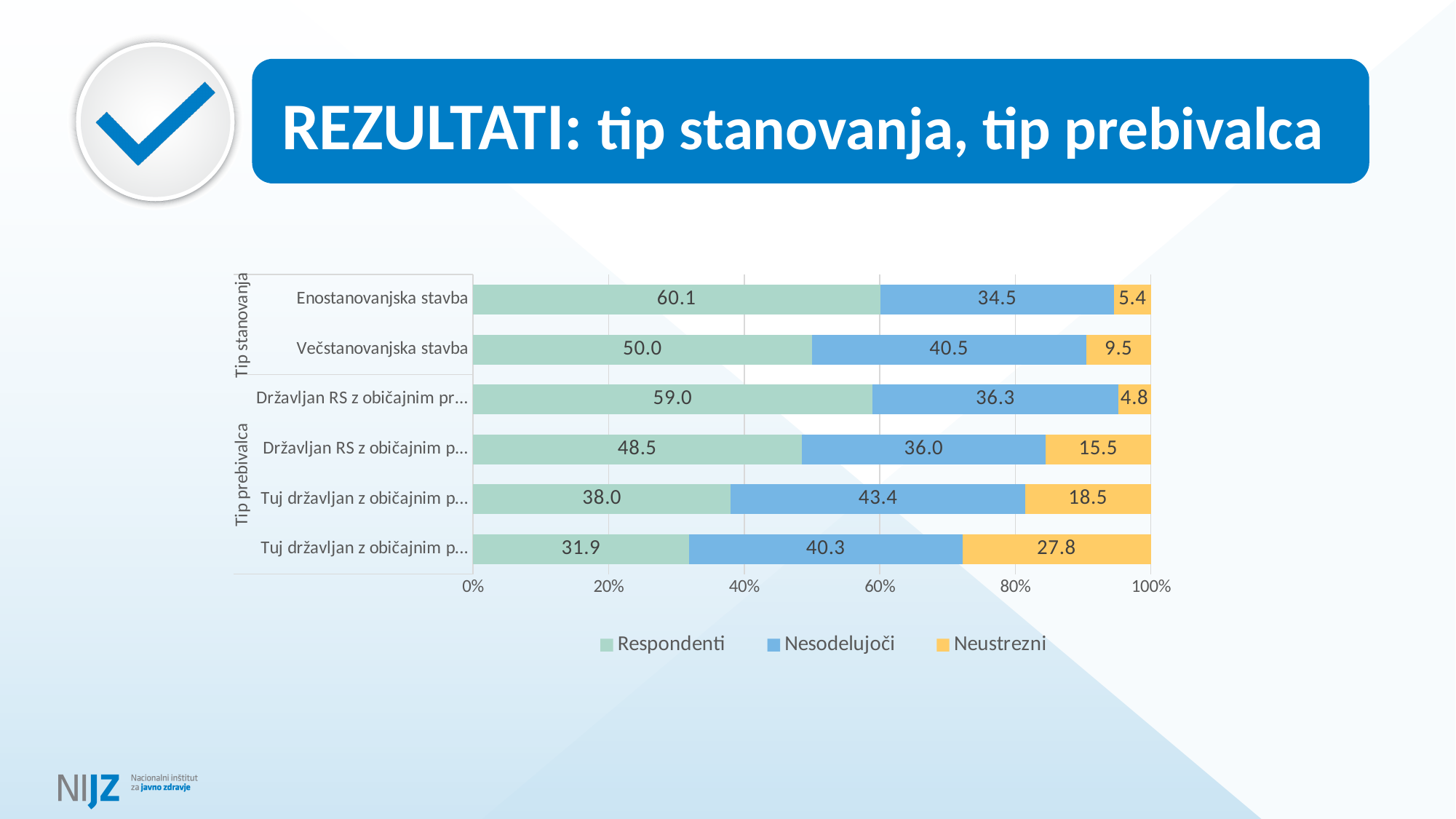
What is the Respondenti value for Enostanovanjska stavba? 60.1 What is the total of the stacked bar for Enostanovanjska stavba? 100.0 What is the lowest Neustrezni value shown in the chart? 4.8 What is the Neustrezni value for Enostanovanjska stavba? 5.4 What kind of chart is shown on the slide? Stacked bar chart What is the Respondenti value for the bottom bar of the chart? 31.9 Which has the larger Nesodelujoči value, Enostanovanjska stavba or Večstanovanjska stavba? Večstanovanjska stavba What is the Nesodelujoči value for Večstanovanjska stavba? 40.5 How many categories (bars) are shown in the chart? 6 How many series does the legend list? 3 What is the highest Neustrezni value shown in the chart? 27.8 How much larger is the Respondenti value for Enostanovanjska stavba than for Večstanovanjska stavba? 10.1